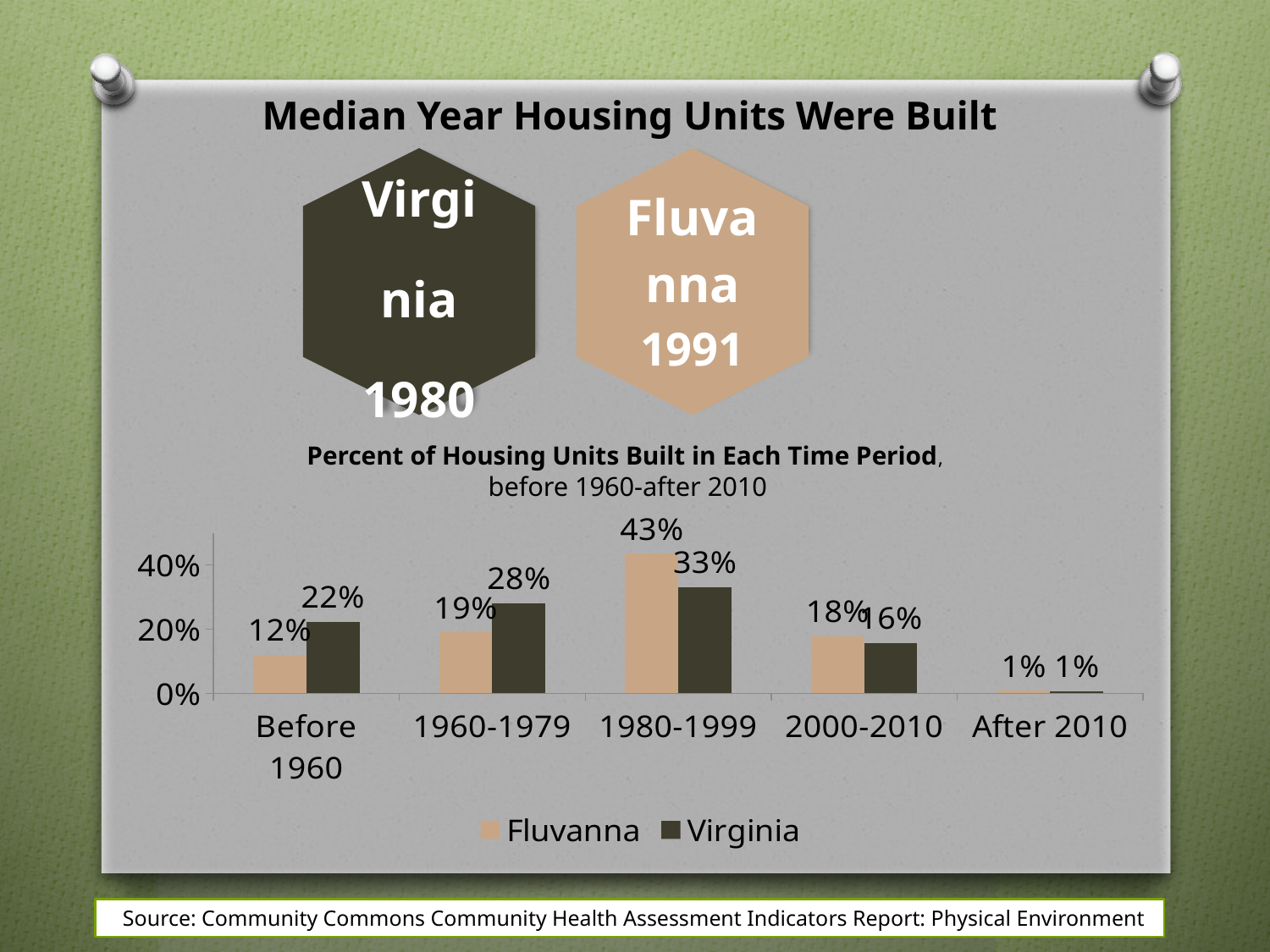
What is the Fluvanna value for the 2000-2010 period? 18% What is the Virginia value for the 1960-1979 period? 28% What percent of Virginia housing units were built before 1960? 22% In which time period is the Fluvanna value highest? 1980-1999 What kind of chart is shown on the slide? Bar chart Which series is shown in the darker colour in the chart? Virginia What is the difference between the Fluvanna and Virginia values for 1980-1999? 10% How many series does the chart legend list? 2 What percent of Fluvanna housing units were built in 1980-1999? 43% In which time period is the Virginia value lowest? After 2010 How many time periods are shown on the x axis of the chart? 5 Which is larger for the period before 1960, the Fluvanna value or the Virginia value? Virginia